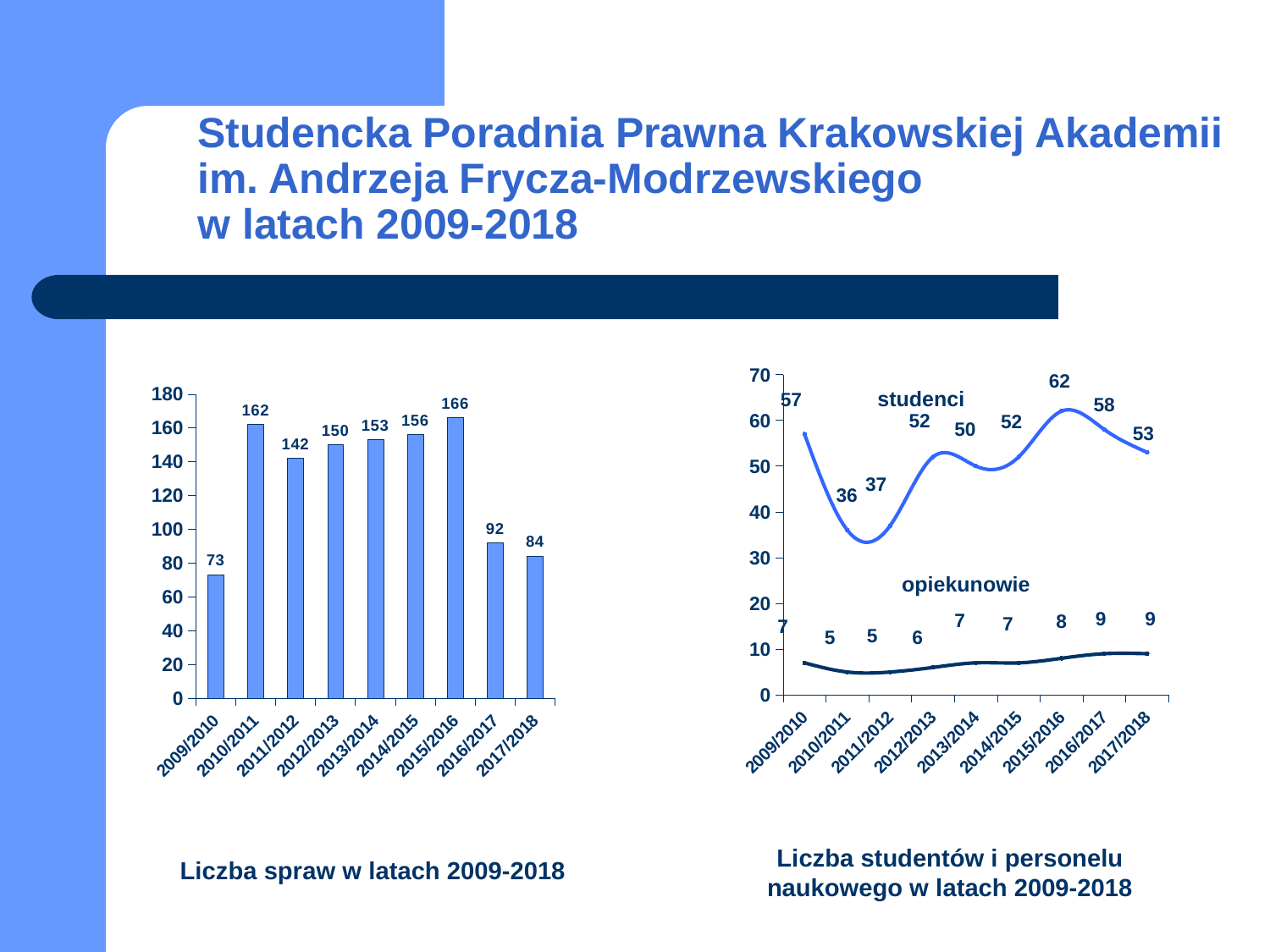
In the chart 'Liczba spraw w latach 2009-2018', how many years are shown on the x axis? 9 In the chart 'Liczba spraw w latach 2009-2018', what is the value for 2015/2016? 166 In the chart 'Liczba studentów i personelu naukowego w latach 2009-2018', which is larger: studenci in 2009/2010 or studenci in 2017/2018? 2009/2010 In the chart 'Liczba studentów i personelu naukowego w latach 2009-2018', what is the value for opiekunowie in 2012/2013? 6 In the chart 'Liczba studentów i personelu naukowego w latach 2009-2018', what is the value for studenci in 2015/2016? 62 In the chart 'Liczba studentów i personelu naukowego w latach 2009-2018', what is the difference between studenci and opiekunowie in 2017/2018? 44 In the chart 'Liczba spraw w latach 2009-2018', what is the difference between the values for 2010/2011 and 2016/2017? 70 In the chart 'Liczba studentów i personelu naukowego w latach 2009-2018', in which year is the studenci value lowest? 2010/2011 In the chart 'Liczba spraw w latach 2009-2018', which year has the lowest value? 2009/2010 What kind of chart is 'Liczba spraw w latach 2009-2018'? bar chart What kind of chart is 'Liczba studentów i personelu naukowego w latach 2009-2018'? line chart In the chart 'Liczba spraw w latach 2009-2018', which year has the highest value? 2015/2016